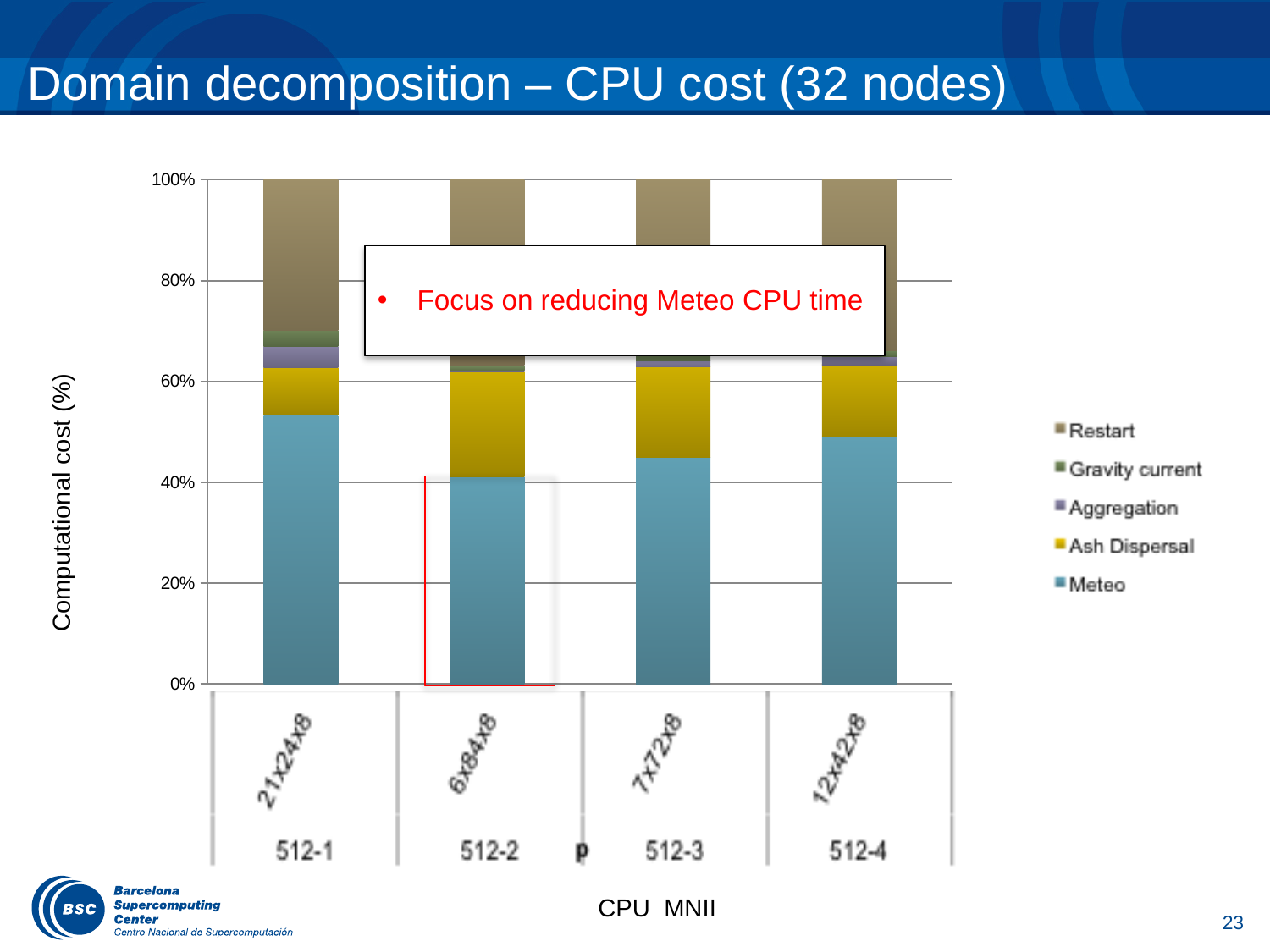
How many series does the legend list? 5 Which category has the smallest Meteo share? 512-2 Is the Meteo share for 512-2 greater or less than 60%? less What is the total height of each stacked bar? 100% Is the Meteo share for 512-3 greater or less than 60%? less Which series is listed first (at the top) in the legend? Restart What is the label on the y axis? Computational cost (%) How many categories (bars) are plotted along the x axis? 4 Which category has the largest Meteo share? 512-1 Which has the larger Meteo share, 512-1 or 512-2? 512-1 Is the Meteo share for 512-1 greater or less than 40%? greater What kind of chart is shown on the slide? stacked bar chart